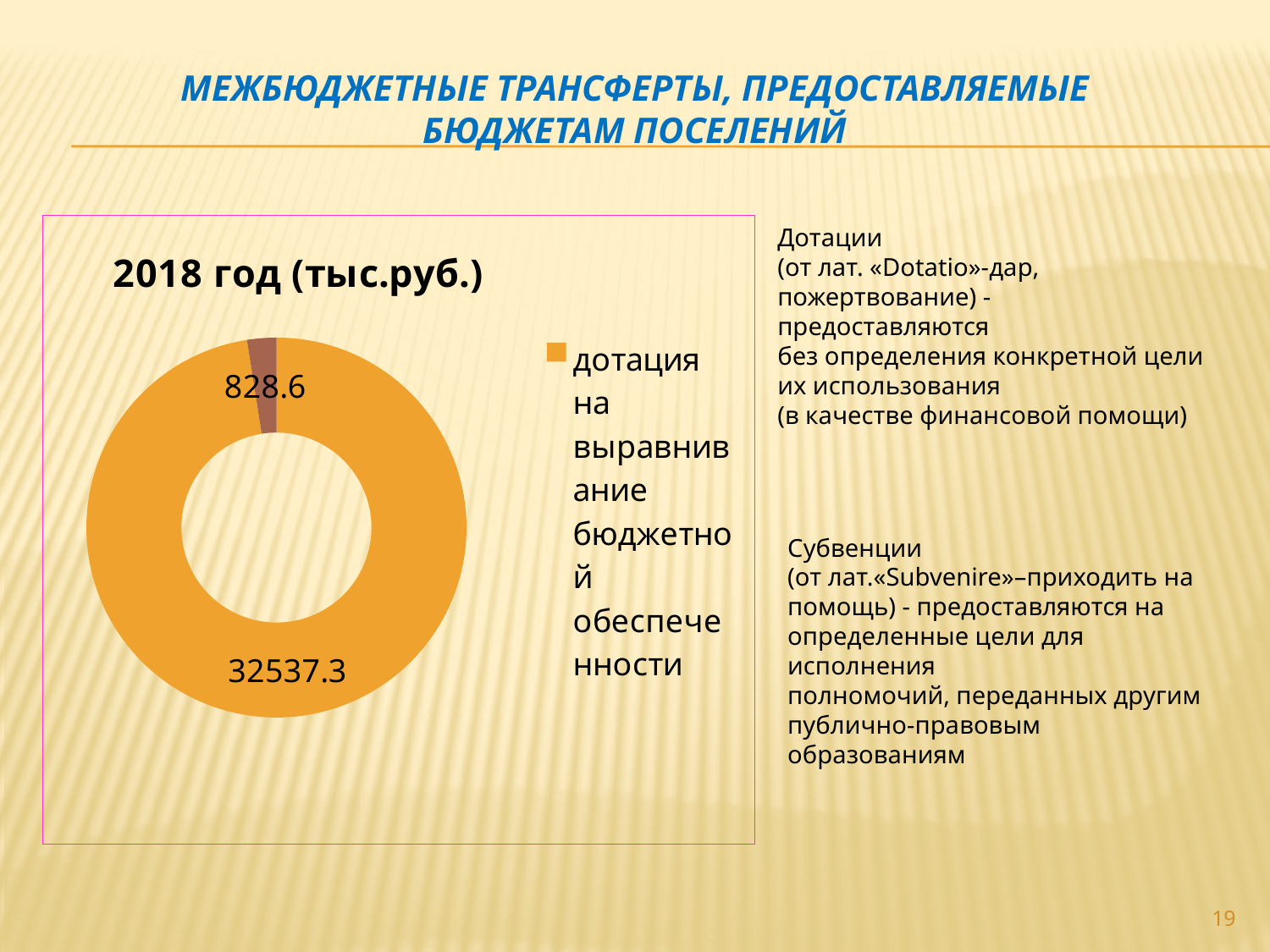
What is the value for дотация на выравнивание бюджетной обеспеченности? 32537.3 What value is printed on the small brown slice of the doughnut? 828.6 What is the difference between the two slice values, 32537.3 and 828.6? 31708.7 What is the title of the chart? 2018 год (тыс.руб.) How many slices does the doughnut chart have? 2 What colour is the slice for дотация на выравнивание бюджетной обеспеченности? orange Which slice of the doughnut is the largest? дотация на выравнивание бюджетной обеспеченности What is the total of the two slice values shown on the chart? 33365.9 What kind of chart is shown on the slide? doughnut chart Which is larger: the orange slice or the brown slice? the orange slice